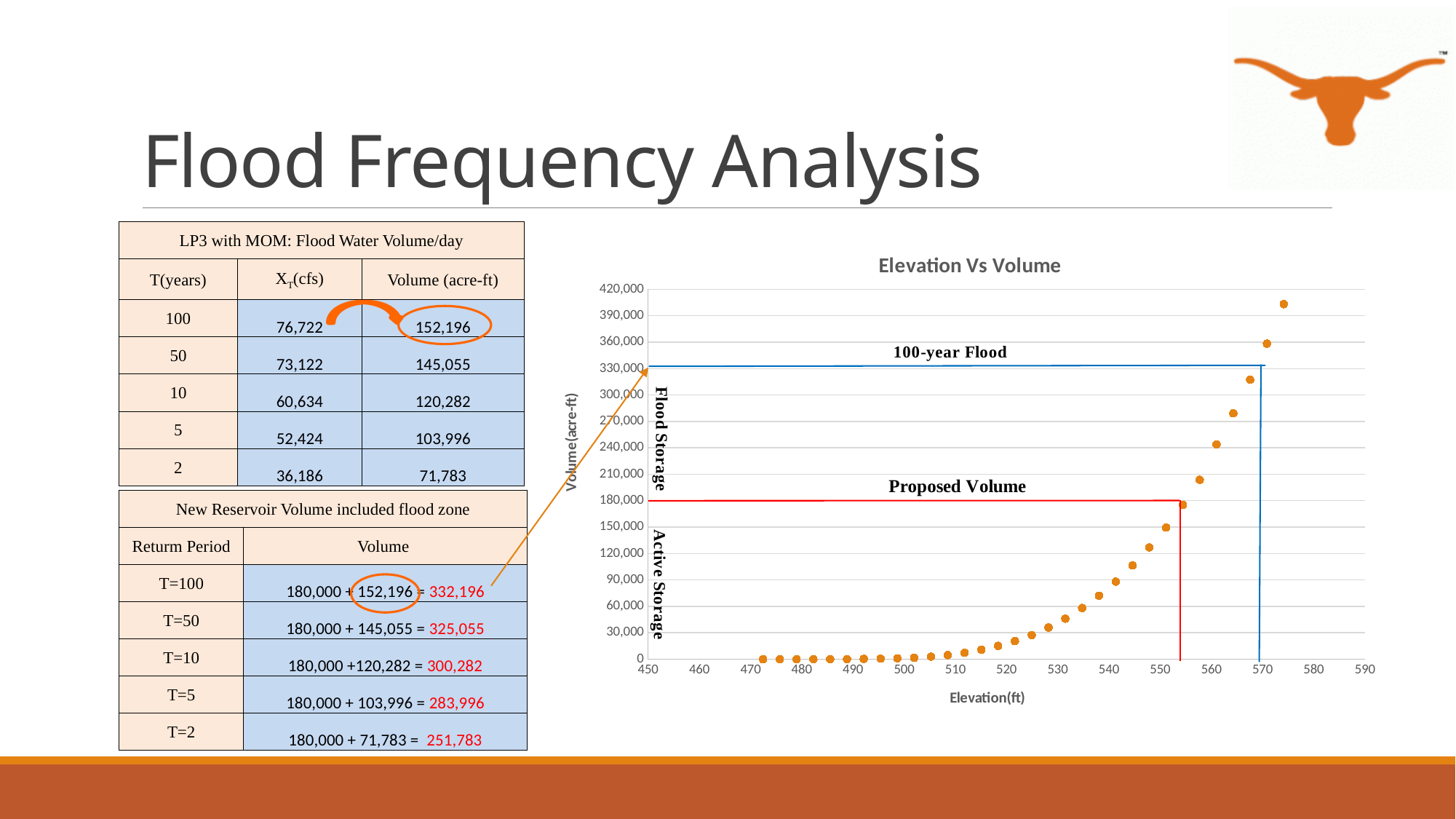
What is the title of the chart? Elevation Vs Volume Is the plotted volume at an elevation of 500 ft greater or less than 30,000? less What kind of chart is shown on the slide? scatter chart Which horizontal line is at a higher volume, '100-year Flood' or 'Proposed Volume'? 100-year Flood Is the plotted volume at an elevation of 550 ft greater or less than 120,000? greater At what volume is the 'Proposed Volume' horizontal line drawn on the chart? 180,000 Is the highest plotted point on the chart greater or less than 360,000 acre-ft? greater Do the plotted volumes rise or fall as elevation increases along the x axis? rise What is the label of the x axis of the chart? Elevation(ft)